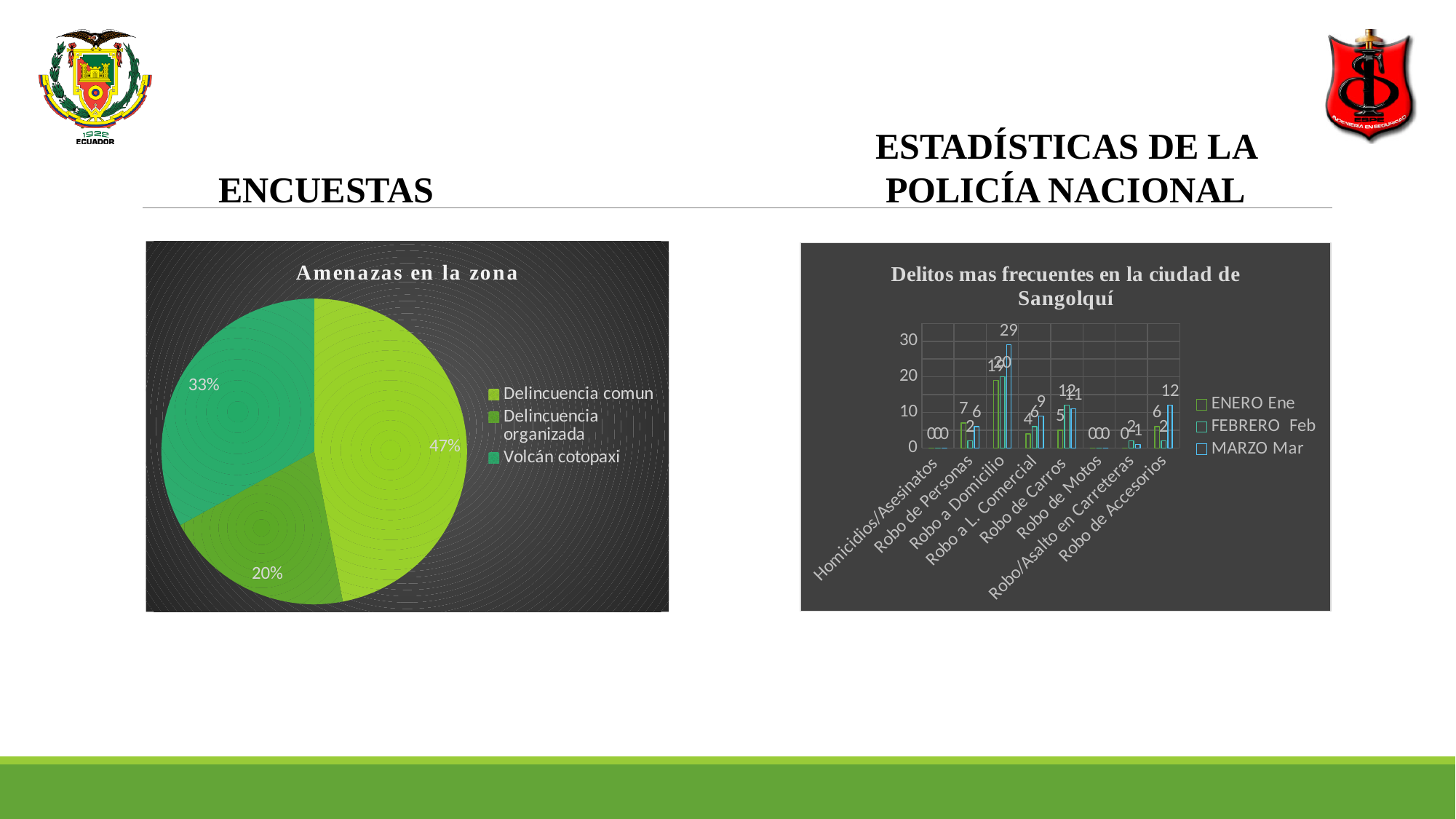
In the 'Amenazas en la zona' chart, what is the difference between the Delincuencia comun and Volcán cotopaxi shares? 14% In the 'Delitos mas frecuentes en la ciudad de Sangolquí' chart, which category has the highest value overall? Robo a Domicilio In the 'Amenazas en la zona' chart, how many slices does the pie have? 3 In the 'Amenazas en la zona' chart, what share does Delincuencia comun have? 47% In the 'Delitos mas frecuentes en la ciudad de Sangolquí' chart, how many series does the legend list? 3 In the 'Delitos mas frecuentes en la ciudad de Sangolquí' chart, what is the ENERO value for Robo de Personas? 7 In the 'Delitos mas frecuentes en la ciudad de Sangolquí' chart, what is the MARZO value for Robo a Domicilio? 29 What kind of chart is 'Delitos mas frecuentes en la ciudad de Sangolquí'? Bar chart What kind of chart is 'Amenazas en la zona'? Pie chart In the 'Amenazas en la zona' chart, which category has the smallest slice? Delincuencia organizada In the 'Delitos mas frecuentes en la ciudad de Sangolquí' chart, what is the MARZO value for Robo de Accesorios? 12 In the 'Amenazas en la zona' chart, what share does Volcán cotopaxi have? 33%